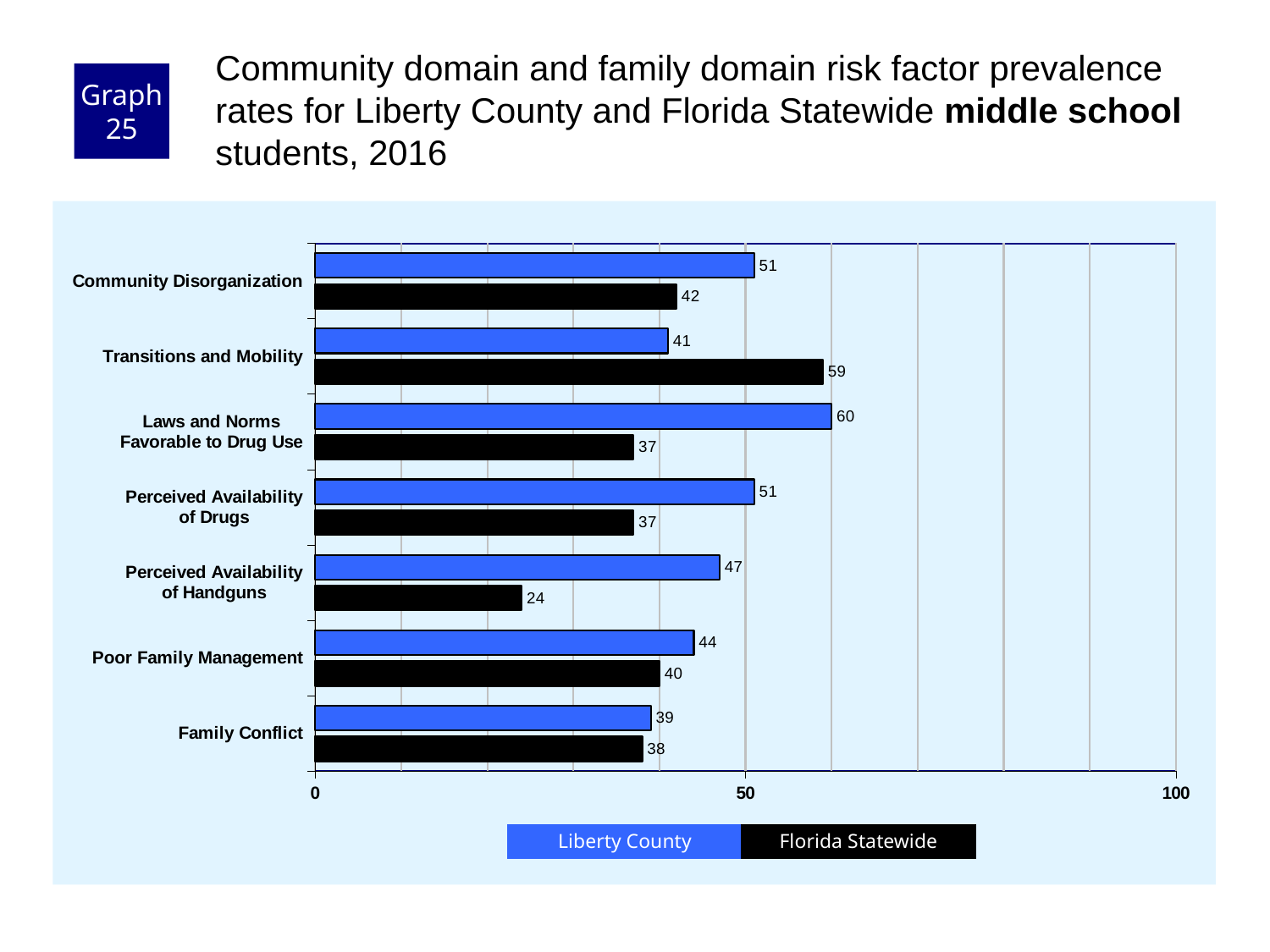
What is the Florida Statewide value for Perceived Availability of Handguns? 24 Which risk factor has the lowest Florida Statewide value? Perceived Availability of Handguns Which risk factor has the highest Liberty County value? Laws and Norms Favorable to Drug Use How many risk factors are shown on the chart? 7 How many series does the legend list? 2 What is the Liberty County value for Laws and Norms Favorable to Drug Use? 60 Which is larger for Transitions and Mobility: the Liberty County value or the Florida Statewide value? Florida Statewide What kind of chart is shown on the slide? Bar chart What is the difference between the Liberty County and Florida Statewide values for Perceived Availability of Handguns? 23 Which colour represents Florida Statewide in the legend? Black Is the Liberty County value for Community Disorganization greater or less than 50? greater What is the Florida Statewide value for Transitions and Mobility? 59